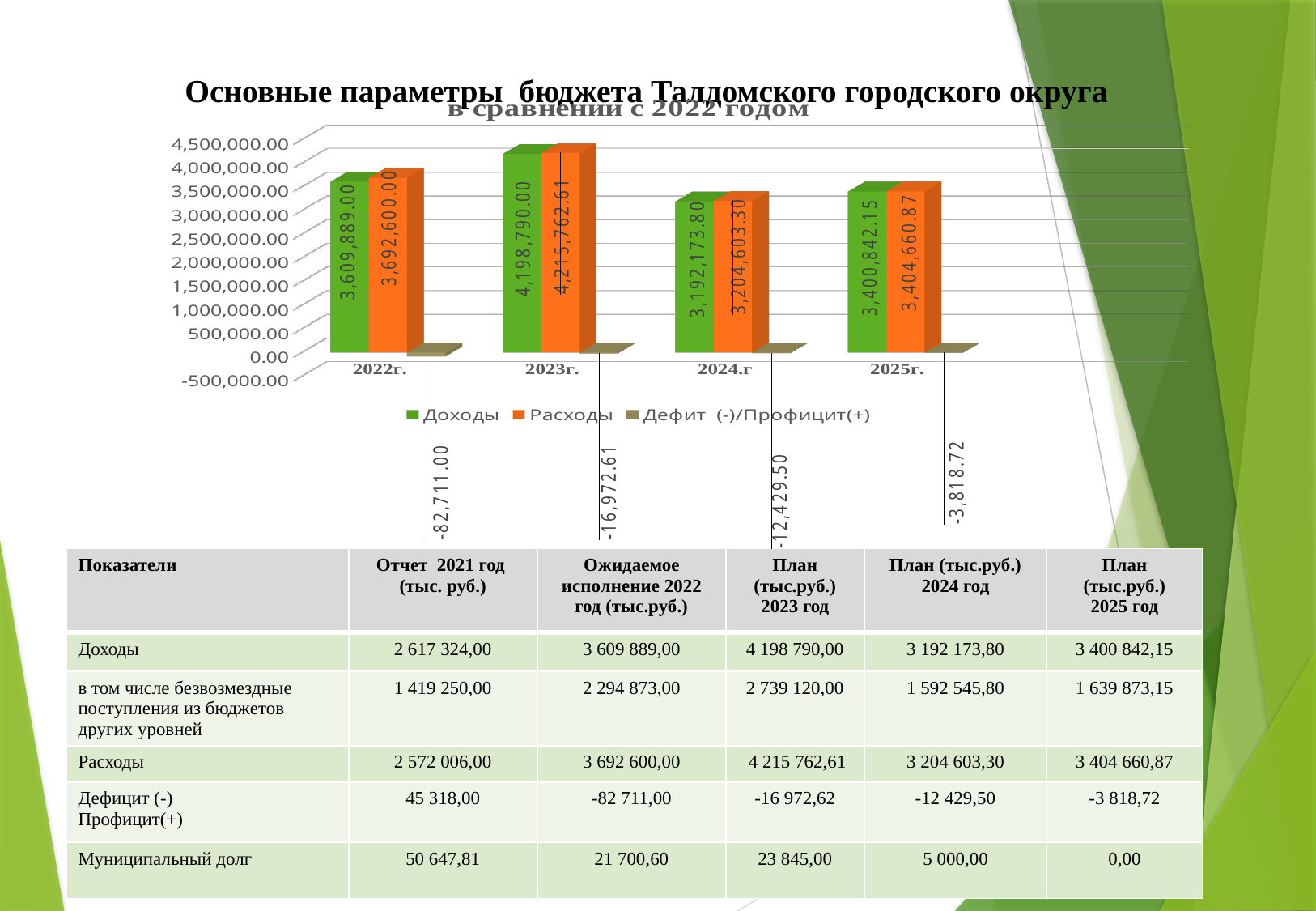
What kind of chart is shown on the slide? bar chart What is the value of Расходы for 2025г.? 3,404,660.87 In which year is the Дефит (-)/Профицит(+) value lowest? 2022г. How many years are shown on the x axis of the chart? 4 In which year is Доходы highest? 2023г. What is the value of Дефит (-)/Профицит(+) for 2024.г? -12,429.50 Is the value of Расходы for 2023г. greater or less than 4,000,000.00? greater In which year is Доходы lowest? 2024.г What is the value of Доходы for 2023г.? 4,198,790.00 Which is larger in 2024.г, Доходы or Расходы? Расходы What is the difference between Расходы and Доходы in 2022г.? 82,711.00 How many series does the chart legend list? 3